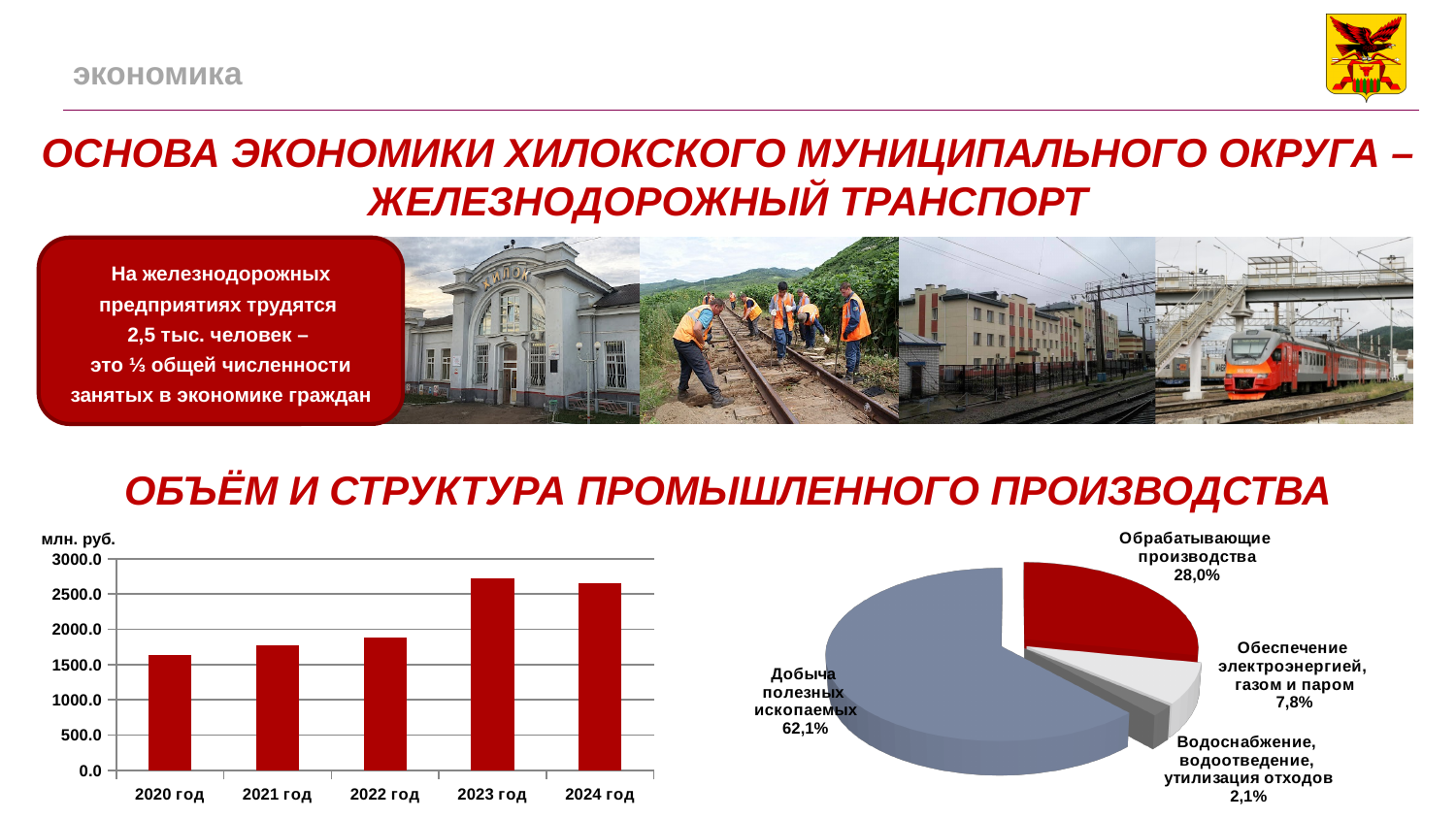
In the right pie chart, what share does 'Добыча полезных ископаемых' have? 62,1% In the left bar chart, which year has the lowest value? 2020 год In the left bar chart, which is larger, the value for 2021 год or 2022 год? 2022 год In the left bar chart, is the value for 2020 год greater or less than 2000.0? less In the left bar chart, which year has the highest value? 2023 год In the left bar chart, do the values rise or fall from 2020 год to 2023 год? rise In the right pie chart, what share does 'Обеспечение электроэнергией, газом и паром' have? 7,8% What kind of chart is the right chart under 'ОБЪЁМ И СТРУКТУРА ПРОМЫШЛЕННОГО ПРОИЗВОДСТВА'? pie chart What kind of chart is the left chart under 'ОБЪЁМ И СТРУКТУРА ПРОМЫШЛЕННОГО ПРОИЗВОДСТВА'? bar chart In the left bar chart, how many years are shown on the x axis? 5 In the right pie chart, what is the difference between the shares of 'Добыча полезных ископаемых' and 'Обрабатывающие производства'? 34,1% In the left bar chart, is the value for 2023 год greater or less than 2500.0? greater